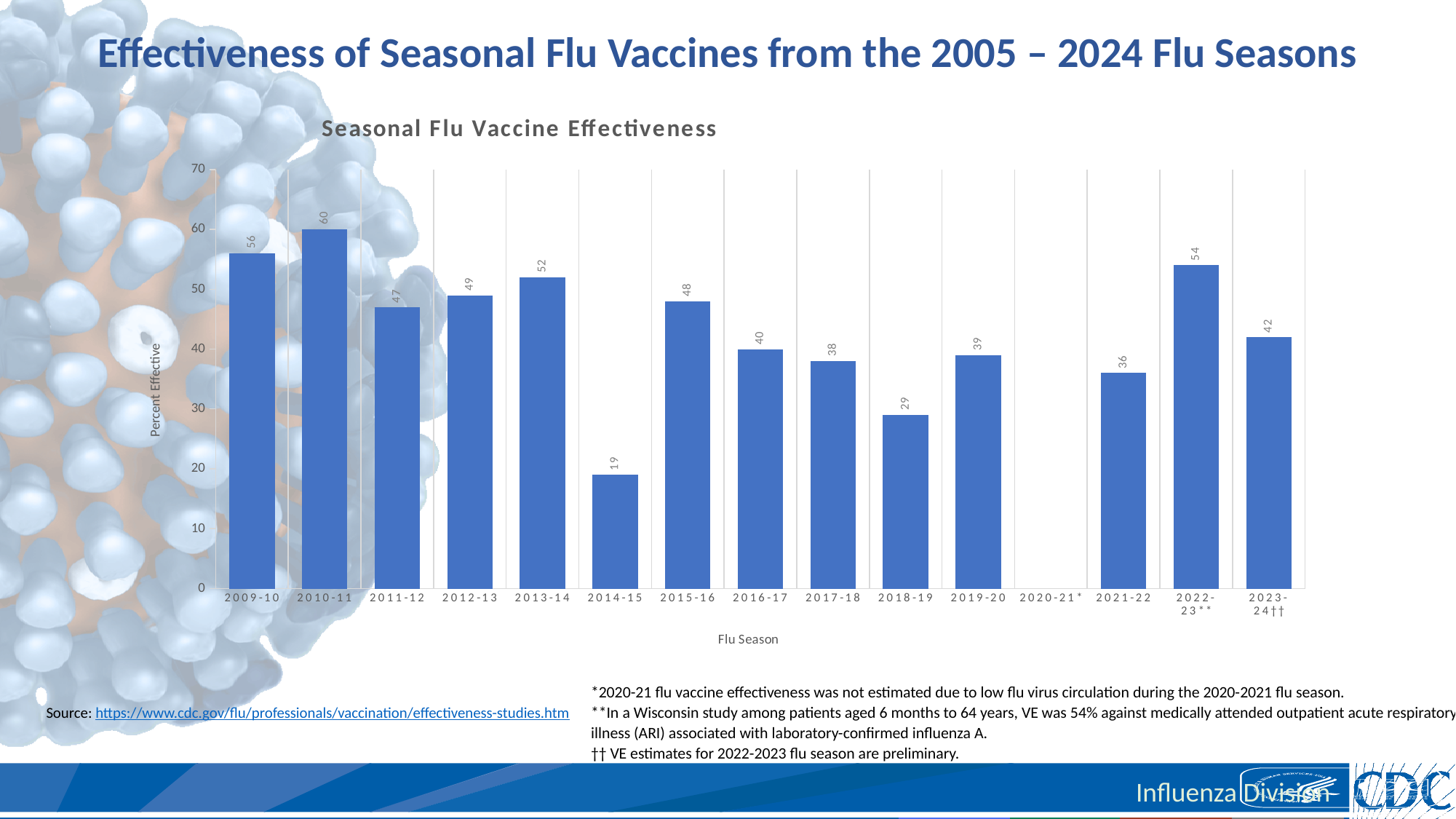
What is the vaccine effectiveness value shown for the 2022-23** flu season? 54 What is the label of the y axis of the chart? Percent Effective What kind of chart is used to show Seasonal Flu Vaccine Effectiveness? Bar chart What is the vaccine effectiveness value shown for the 2014-15 flu season? 19 Which flu season has the highest vaccine effectiveness value in the chart? 2010-11 How many flu seasons are listed on the x axis of the chart? 15 Which flu season on the x axis has no bar plotted? 2020-21* Which flu season has a higher vaccine effectiveness value, 2013-14 or 2021-22? 2013-14 What is the vaccine effectiveness value shown for the 2010-11 flu season? 60 What is the difference between the vaccine effectiveness values for the 2009-10 and 2018-19 flu seasons? 27 Which flu season has the lowest plotted vaccine effectiveness value in the chart? 2014-15 Is the value for the 2023-24†† flu season greater or less than 40? greater